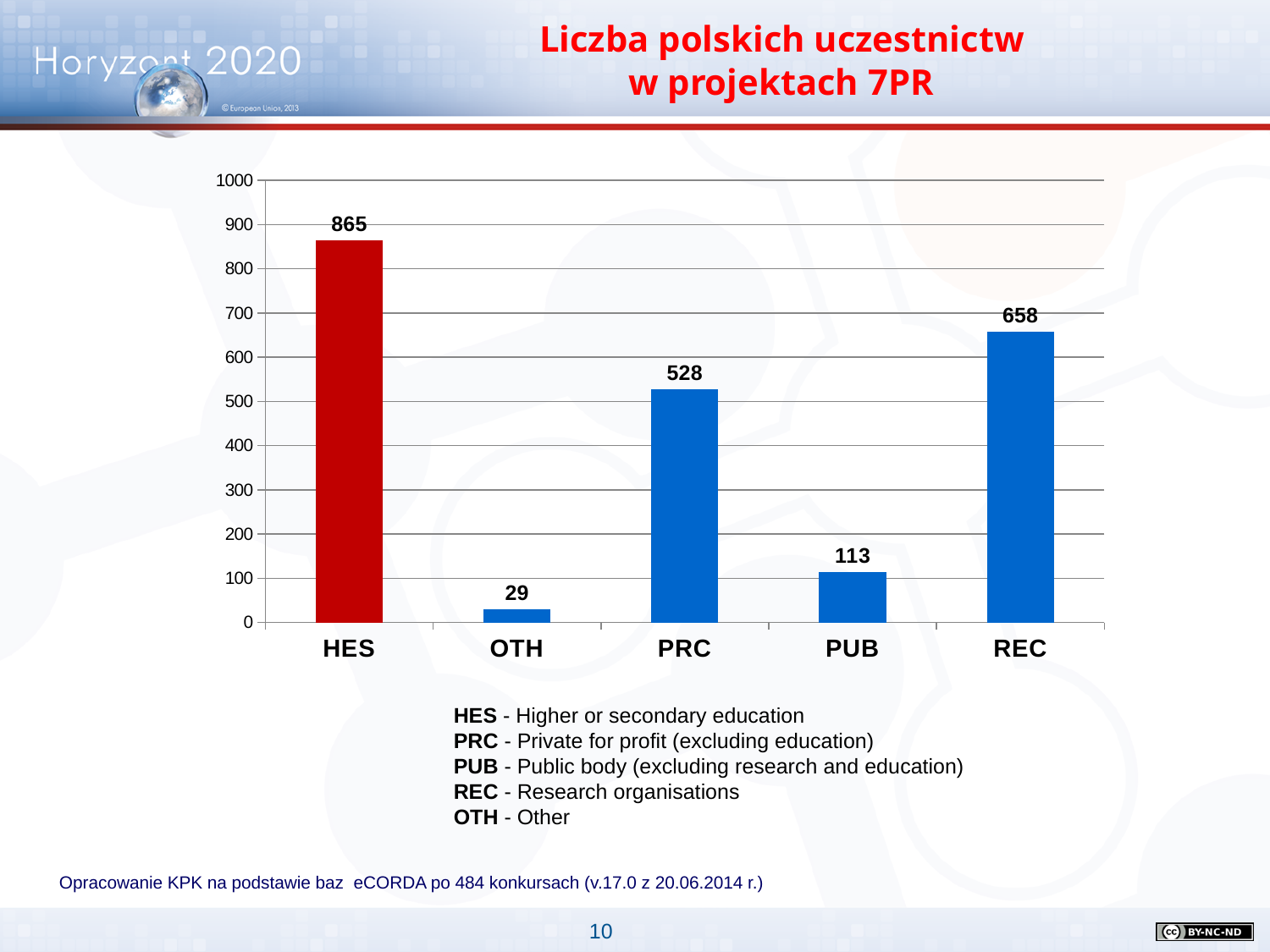
Which category has the lowest value? OTH What is the value for PUB? 113 What kind of chart is shown on the slide? bar chart What is the difference between the values for PRC and PUB? 415 Which is larger, the value for REC or the value for PRC? REC What is the difference between the values for HES and REC? 207 Which bar is coloured red rather than blue? HES Which category has the highest value? HES What is the value for PRC? 528 How many categories are shown on the x axis? 5 What is the value for OTH? 29 What is the value for HES? 865